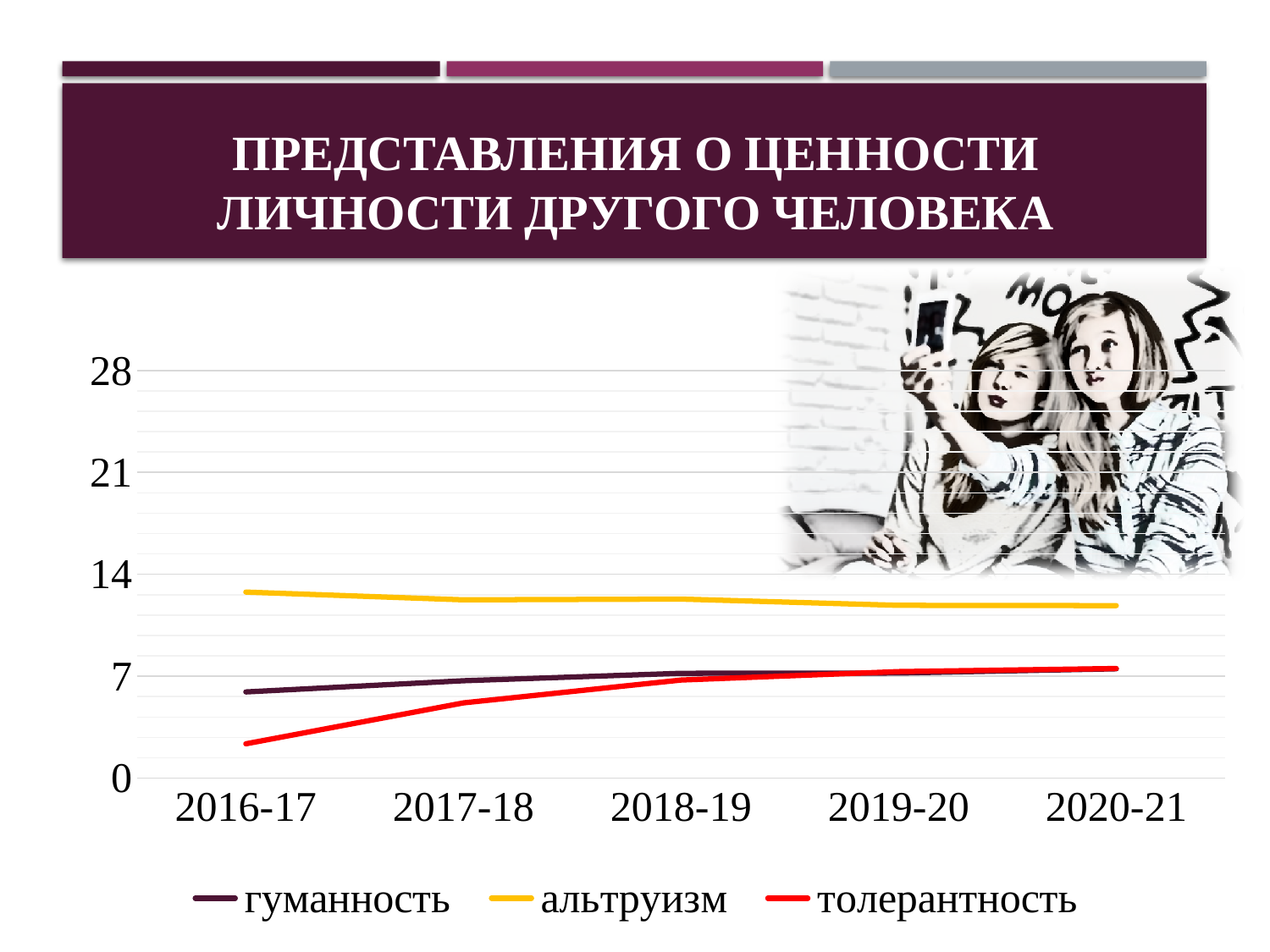
Does the value for толерантность rise or fall from 2016-17 to 2020-21? rise Is the value for толерантность in 2016-17 greater or less than 7? less Is the value for альтруизм in 2016-17 greater or less than 14? less What colour is the line for толерантность? red What kind of chart is shown on the slide? line chart Which is larger in 2016-17, the value for альтруизм or the value for гуманность? альтруизм Which series has the highest value in 2020-21? альтруизм Is the value for альтруизм in 2020-21 greater or less than 7? greater How many periods are shown on the x axis? 5 Does the value for альтруизм rise or fall from 2016-17 to 2020-21? fall How many series does the legend list? 3 Which series has the lowest value in 2016-17? толерантность